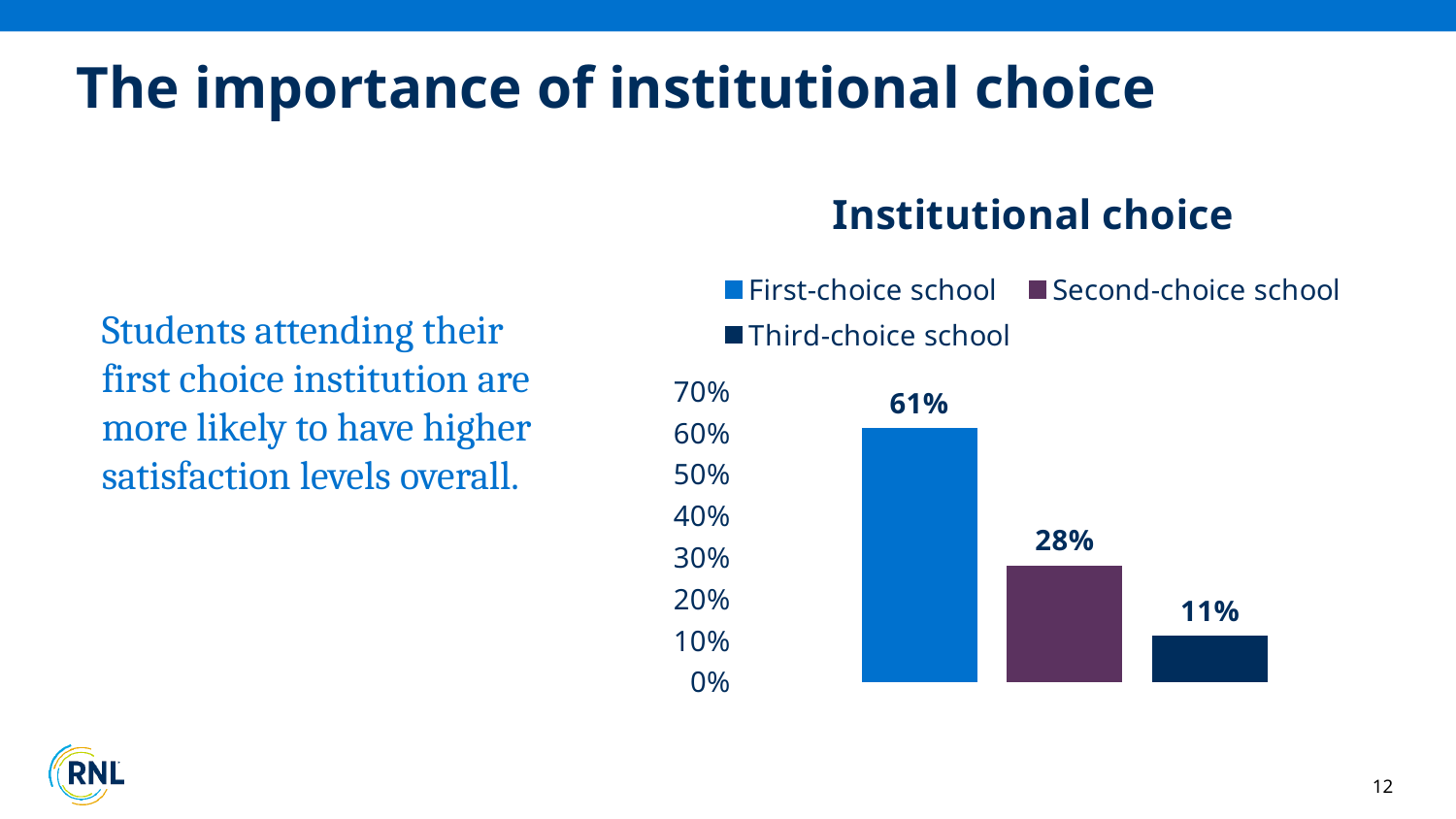
How many series does the legend list? 3 Is the value for First-choice school greater or less than 50%? greater What is the value for Second-choice school? 28% What is the title of the chart? Institutional choice What is the value for Third-choice school? 11% What is the difference between the values for First-choice school and Second-choice school? 33% What is the value for First-choice school? 61% What kind of chart is shown? Bar chart What is the difference between the values for Second-choice school and Third-choice school? 17% Which is larger, the value for Second-choice school or Third-choice school? Second-choice school Which category has the lowest value? Third-choice school Which category has the highest value? First-choice school